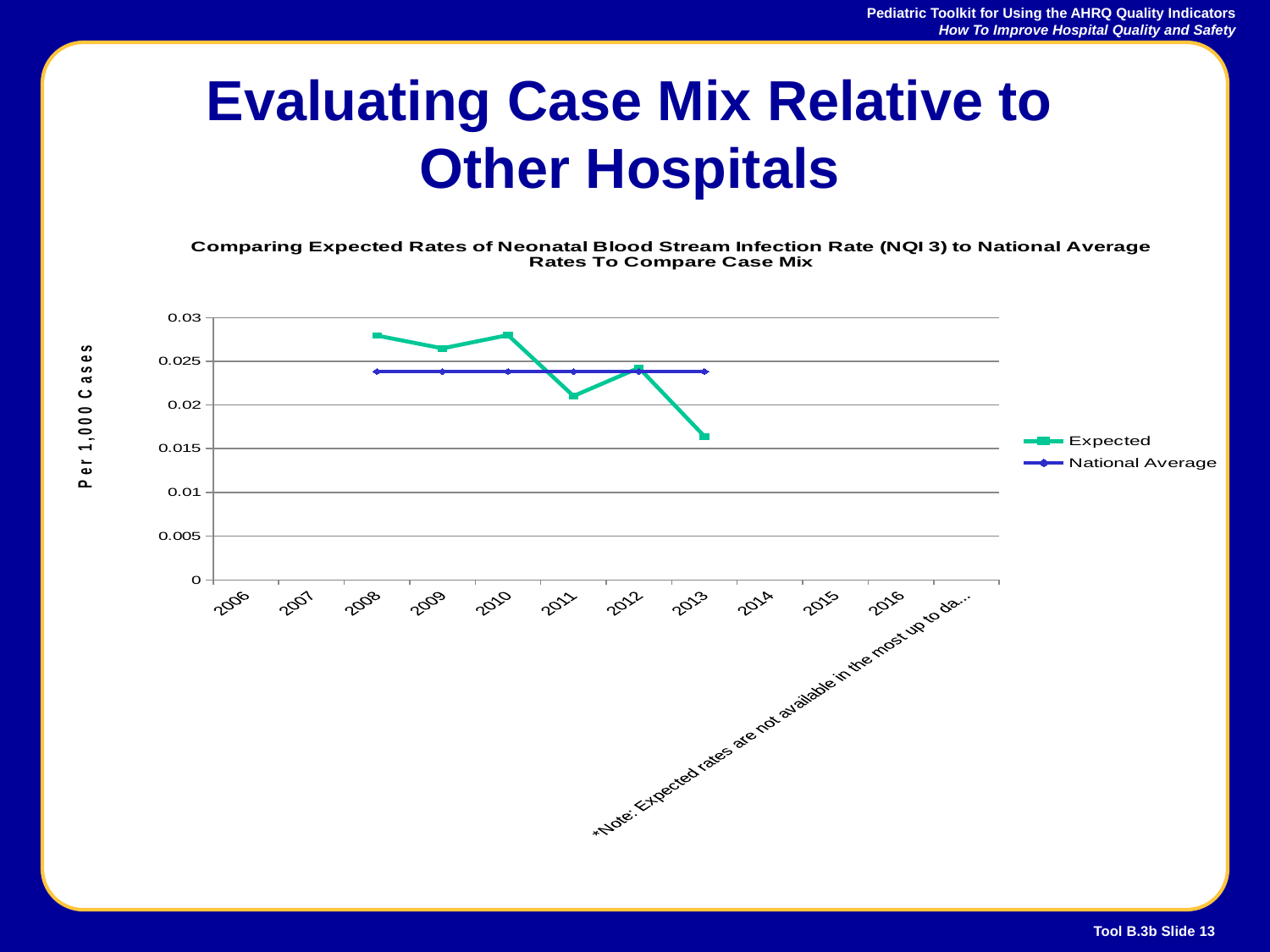
Is the Expected value for 2013 greater or less than 0.02? less What kind of chart is shown on the slide? Line chart Is the National Average value greater or less than 0.02? greater How many series does the chart legend list? 2 In which year is the Expected rate lowest? 2013 Is the Expected value for 2008 greater or less than 0.025? greater In 2013, which series has the larger value, Expected or National Average? National Average What is the label on the vertical axis of the chart? Per 1,000 Cases Overall, does the Expected rate rise or fall from 2008 to 2013? Fall What are the two series named in the chart legend? Expected and National Average Which is larger, the Expected value for 2008 or the Expected value for 2011? 2008